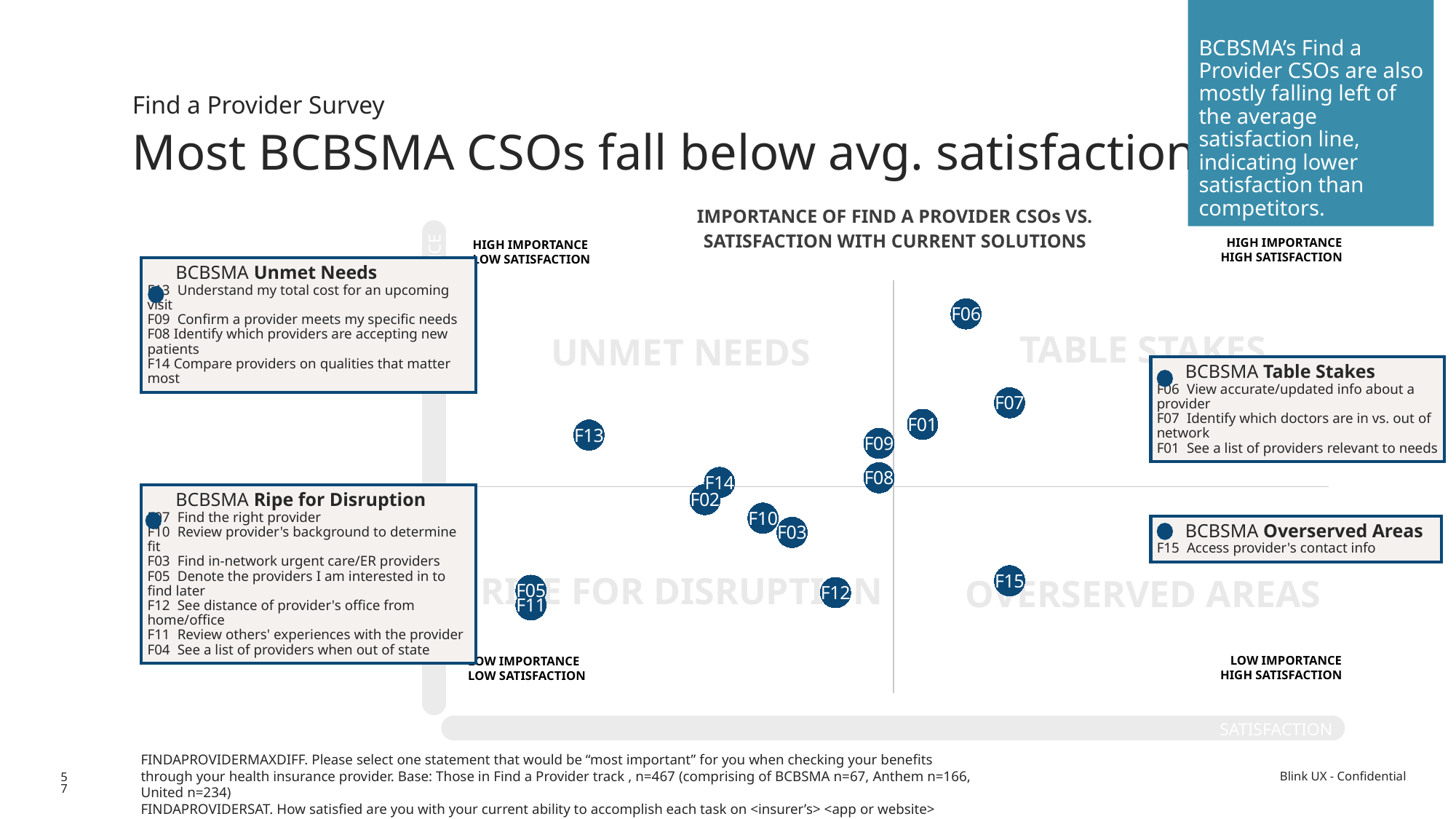
How many points are plotted in the Overserved Areas quadrant? 1 Which quadrant of the chart does F13 fall in? Unmet Needs How many points are plotted in the Table Stakes quadrant? 3 Which quadrant of the chart does F15 fall in? Overserved Areas Which point has higher satisfaction, F13 or F15? F15 What does the horizontal axis of the chart represent? Satisfaction Which point has higher importance, F06 or F13? F06 Which point is plotted with the highest importance? F06 Which quadrant of the chart does F06 fall in? Table Stakes Which quadrant of the chart does F12 fall in? Ripe for Disruption What is the title of the chart? IMPORTANCE OF FIND A PROVIDER CSOs VS. SATISFACTION WITH CURRENT SOLUTIONS What kind of chart is shown on the slide? scatter chart